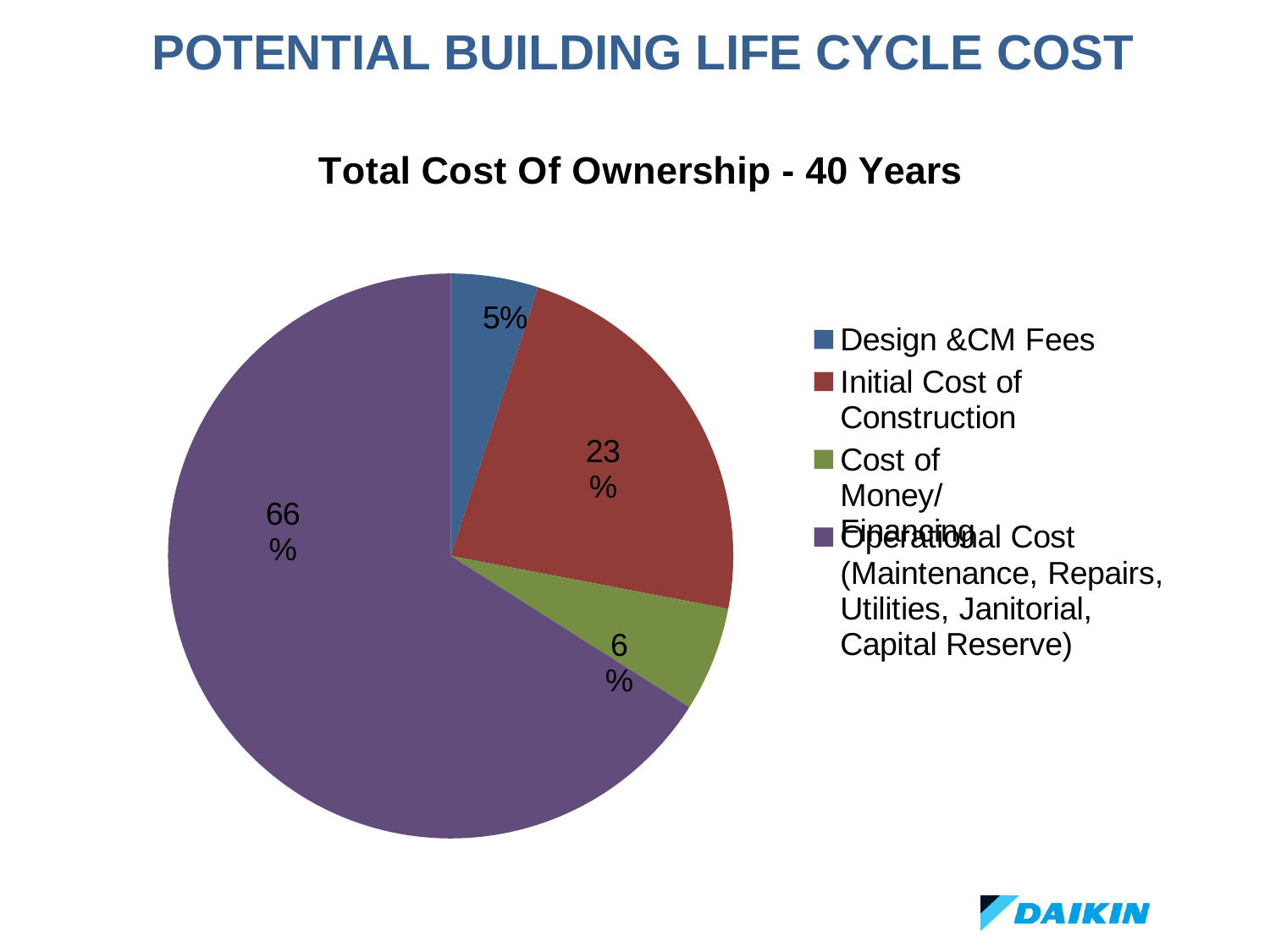
What is the difference in percentage points between Operational Cost and Initial Cost of Construction? 43 What is the title of the chart? Total Cost Of Ownership - 40 Years Which category has the largest share of the pie? Operational Cost (Maintenance, Repairs, Utilities, Janitorial, Capital Reserve) What share of the pie is Design &CM Fees? 5% What share of the pie is Operational Cost (Maintenance, Repairs, Utilities, Janitorial, Capital Reserve)? 66% What colour is the slice for Initial Cost of Construction? red How many categories does the pie chart have? 4 Which is larger, the share for Initial Cost of Construction or the share for Cost of Money/Financing? Initial Cost of Construction Which category has the smallest share of the pie? Design &CM Fees What kind of chart is shown on the slide? pie chart What share of the pie is Cost of Money/Financing? 6%